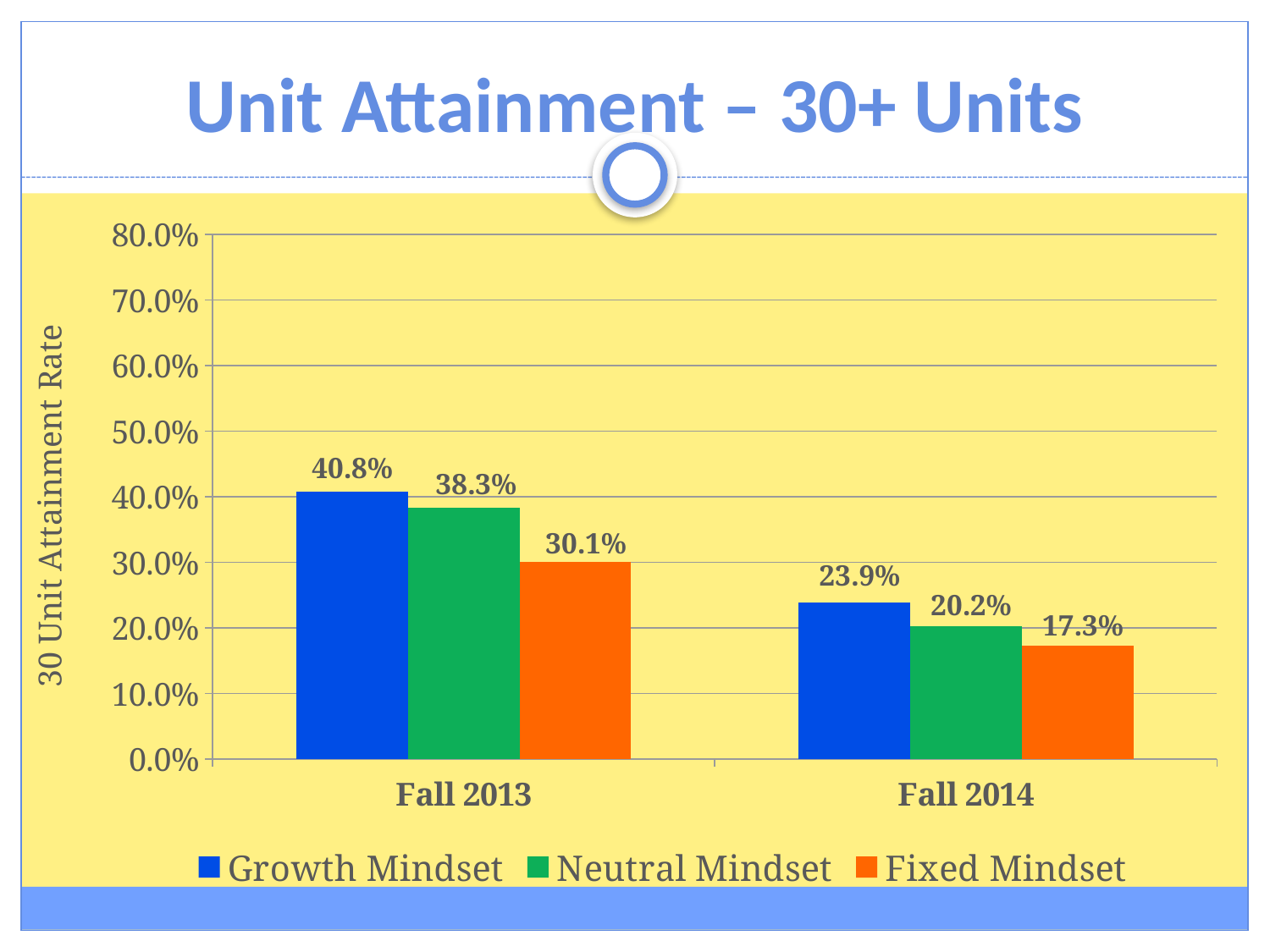
What is the difference between the Growth Mindset attainment rate in Fall 2013 and in Fall 2014? 16.9% What is the 30 unit attainment rate for Neutral Mindset in Fall 2014? 20.2% What is the 30 unit attainment rate for Fixed Mindset in Fall 2014? 17.3% How many series does the legend list? 3 Which mindset group has the lowest 30 unit attainment rate in Fall 2014? Fixed Mindset Do the attainment rates for each mindset group rise or fall from Fall 2013 to Fall 2014? Fall What kind of chart is shown on the slide? Bar chart Which mindset group has the highest 30 unit attainment rate in Fall 2013? Growth Mindset What is the difference between the Growth Mindset and Fixed Mindset attainment rates in Fall 2013? 10.7% Which is larger: the Neutral Mindset rate in Fall 2013 or the Growth Mindset rate in Fall 2014? Neutral Mindset in Fall 2013 Is the Fixed Mindset value for Fall 2013 greater or less than 20.0%? greater What is the 30 unit attainment rate for Growth Mindset in Fall 2013? 40.8%